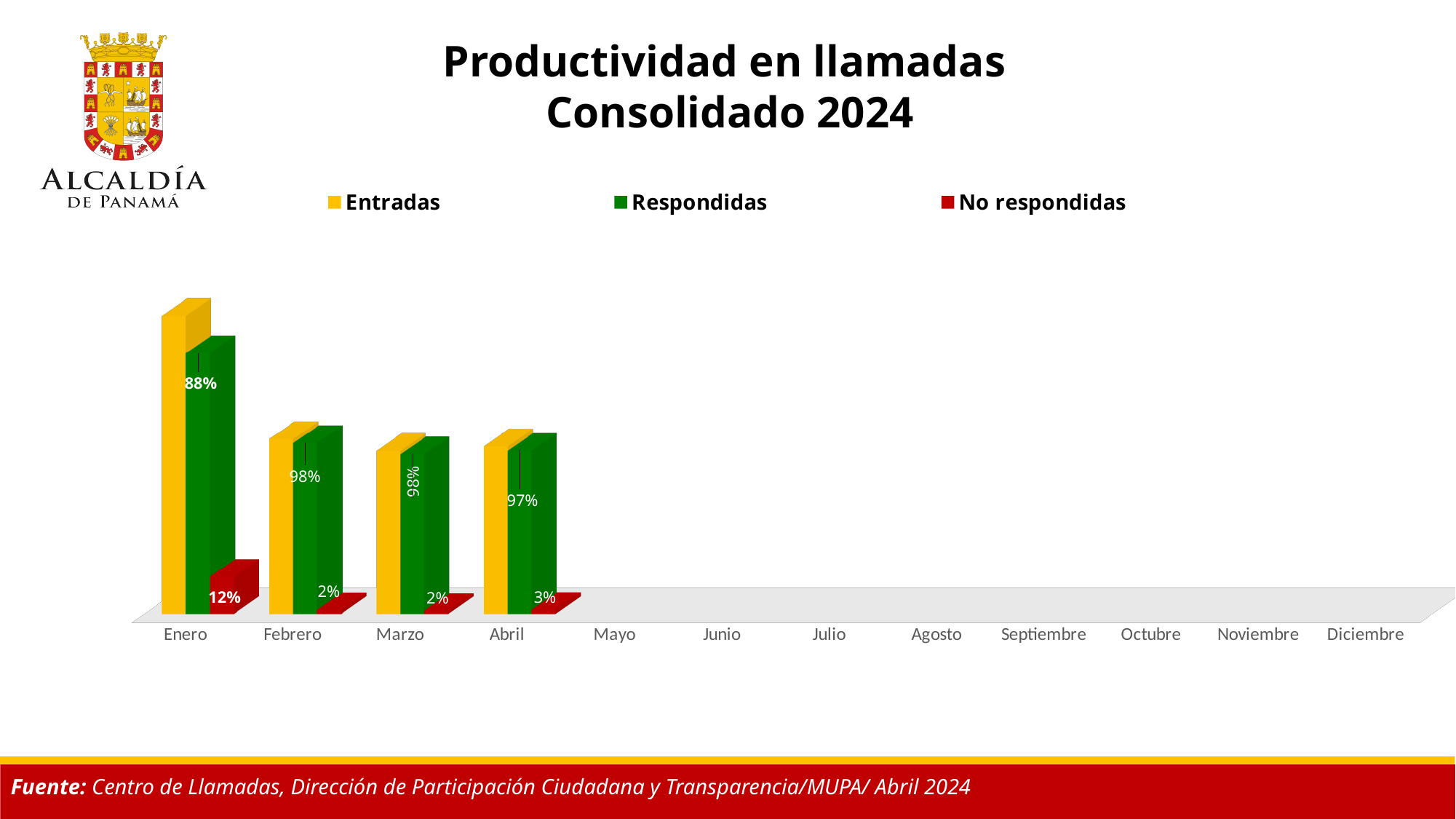
How many series does the legend list? 3 What is the Respondidas value for Abril? 97% What is the Respondidas value for Enero? 88% How many months are labelled on the x axis? 12 Which month has the tallest Entradas bar? Enero What is the No respondidas value for Marzo? 2% Which month has the highest No respondidas value? Enero What is the difference between the Respondidas values for Febrero and Enero? 10 percentage points What kind of chart is shown on the slide? Bar chart What is the No respondidas value for Enero? 12% Which is larger, the Respondidas value for Febrero or for Abril? Febrero